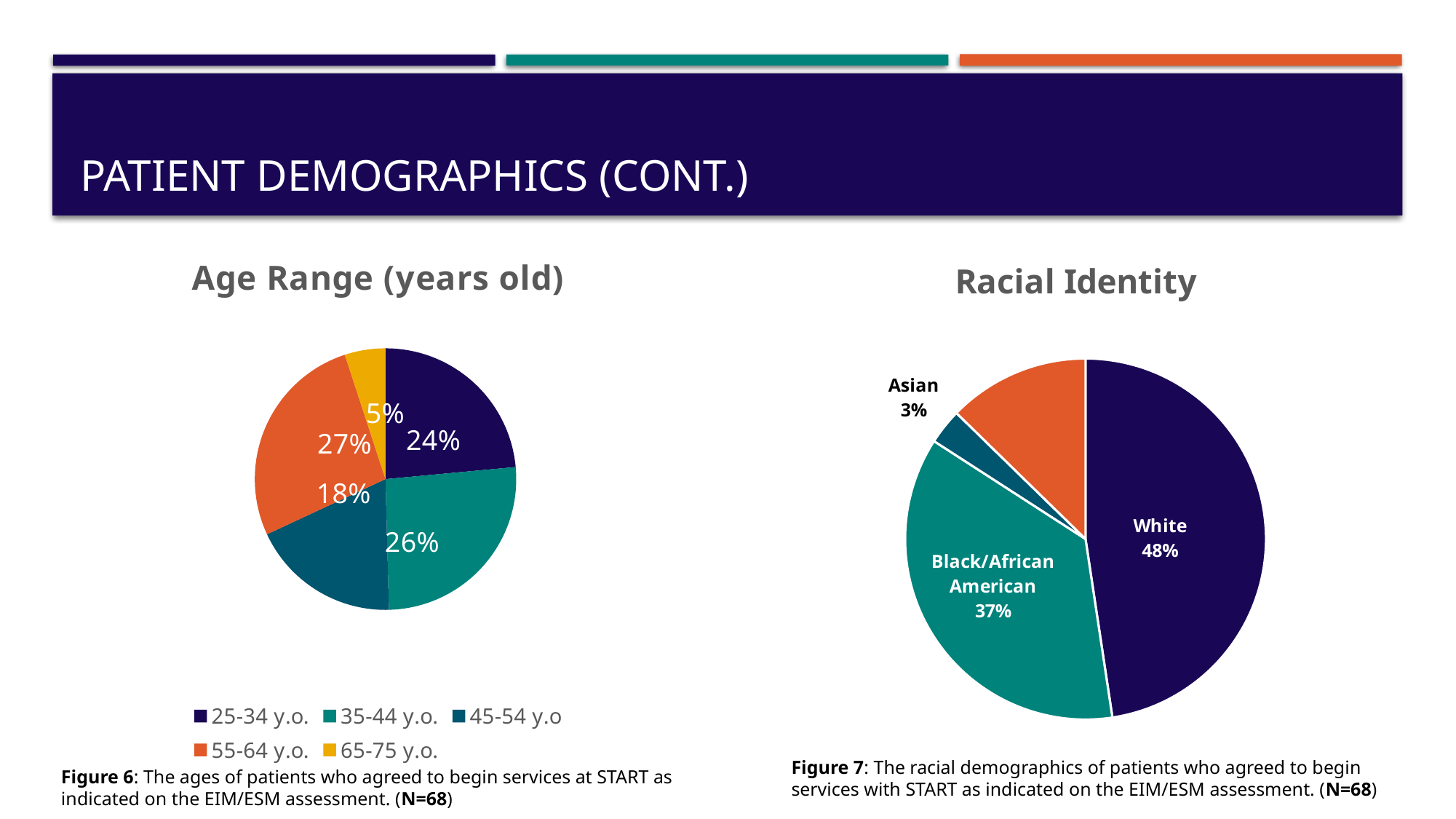
How many age groups does the legend of the Age Range (years old) chart list? 5 In the Racial Identity chart, what is the difference between the White share and the Asian share? 45% In the Age Range (years old) chart, which age group has the smallest share? 65-75 y.o. In the Age Range (years old) chart, which age group has the largest share? 55-64 y.o. In the Age Range (years old) chart, what percentage of patients are 65-75 y.o.? 5% In the Racial Identity chart, what percentage of patients are Black/African American? 37% In the Racial Identity chart, what percentage of patients are White? 48% What is the title of the pie chart on the right side of the slide? Racial Identity What kind of chart is the Age Range (years old) chart? pie chart In the Age Range (years old) chart, what percentage of patients are 35-44 y.o.? 26% In the Racial Identity chart, which is larger, the White slice or the Black/African American slice? White In the Age Range (years old) chart, what is the difference between the 25-34 y.o. share and the 45-54 y.o share? 6%